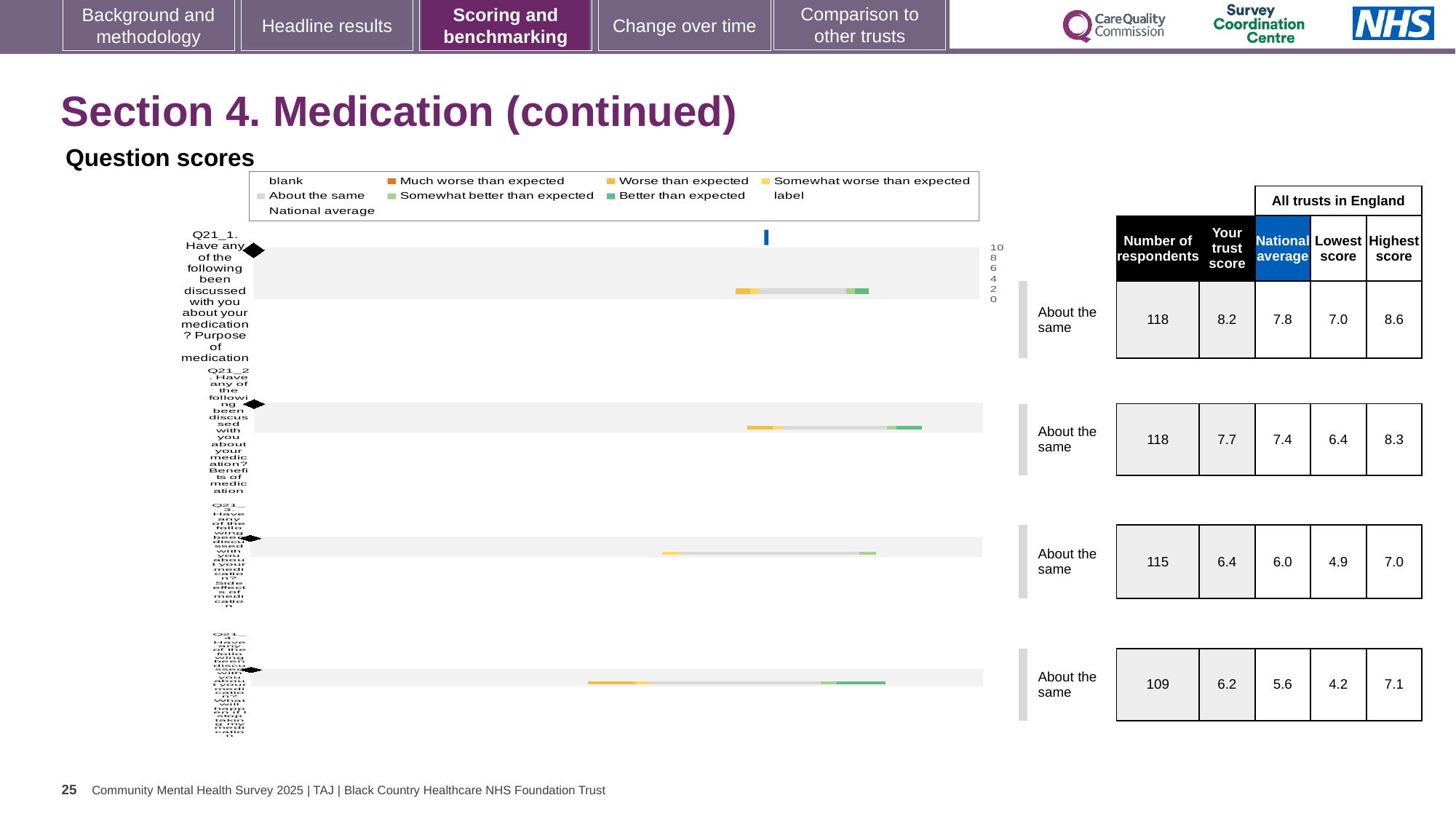
How many respondents answered Q21_4? 109 What is the maximum value shown on the chart's score axis? 10 What kind of chart is shown on the slide? bar chart What is the difference between the trust score and the national average for Q21_1? 0.4 Which question has the highest 'Your trust score'? Q21_1 Which question has the lowest 'Your trust score'? Q21_4 For Q21_2, which is larger: the trust score or the national average? the trust score What is the heading above the chart? Question scores How many question categories (rows) are plotted in the chart? 4 What is the national average for Q21_3 (Side effects of medication)? 6.0 How many entries does the chart legend list? 9 What is the 'Your trust score' for Q21_1 (Purpose of medication)? 8.2